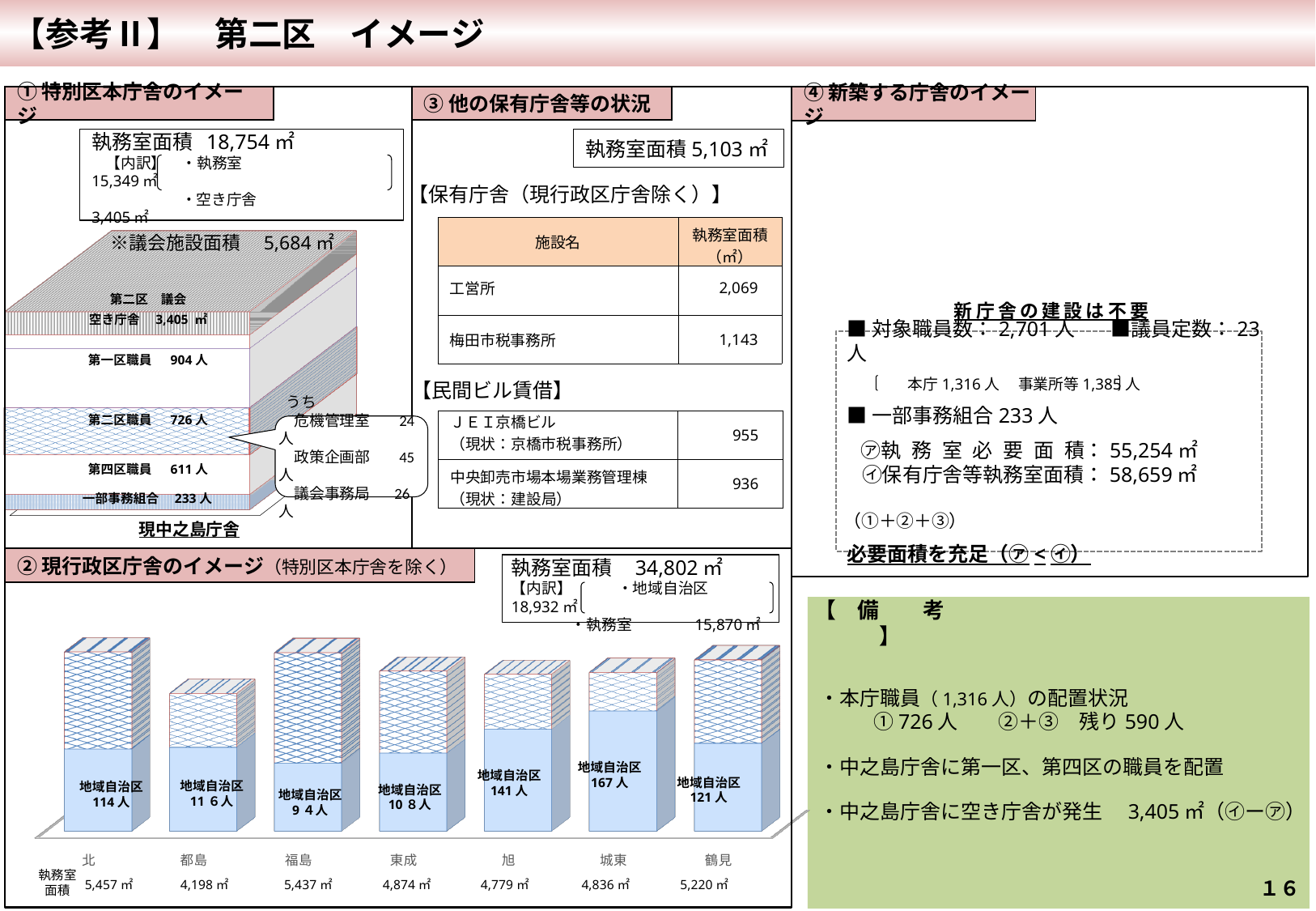
In the ② 現行政区庁舎のイメージ chart, which ward has the smallest 執務室面積? 都島 In the ② 現行政区庁舎のイメージ chart, what is the 執務室面積 for 北? 5,457㎡ In the ① 特別区本庁舎のイメージ stacked building diagram, how many 第一区職員 are shown? 904人 In the ② 現行政区庁舎のイメージ chart, which ward has the smallest number of 地域自治区 staff? 福島 In the ② 現行政区庁舎のイメージ chart, how many wards (categories) are shown? 7 In the ② 現行政区庁舎のイメージ chart, what is the 執務室面積 for 鶴見? 5,220㎡ What total 執務室面積 is shown in the box above the ② 現行政区庁舎のイメージ chart? 34,802㎡ In the ② 現行政区庁舎のイメージ chart, which ward has the largest number of 地域自治区 staff? 城東 What kind of chart is shown in section ② 現行政区庁舎のイメージ? bar chart In the ② 現行政区庁舎のイメージ chart, what is the difference in 地域自治区 staff between 城東 and 福島? 73人 In the ② 現行政区庁舎のイメージ chart, which has more 地域自治区 staff, 旭 or 鶴見? 旭 In the ② 現行政区庁舎のイメージ chart, how many 地域自治区 staff are shown for 城東? 167人